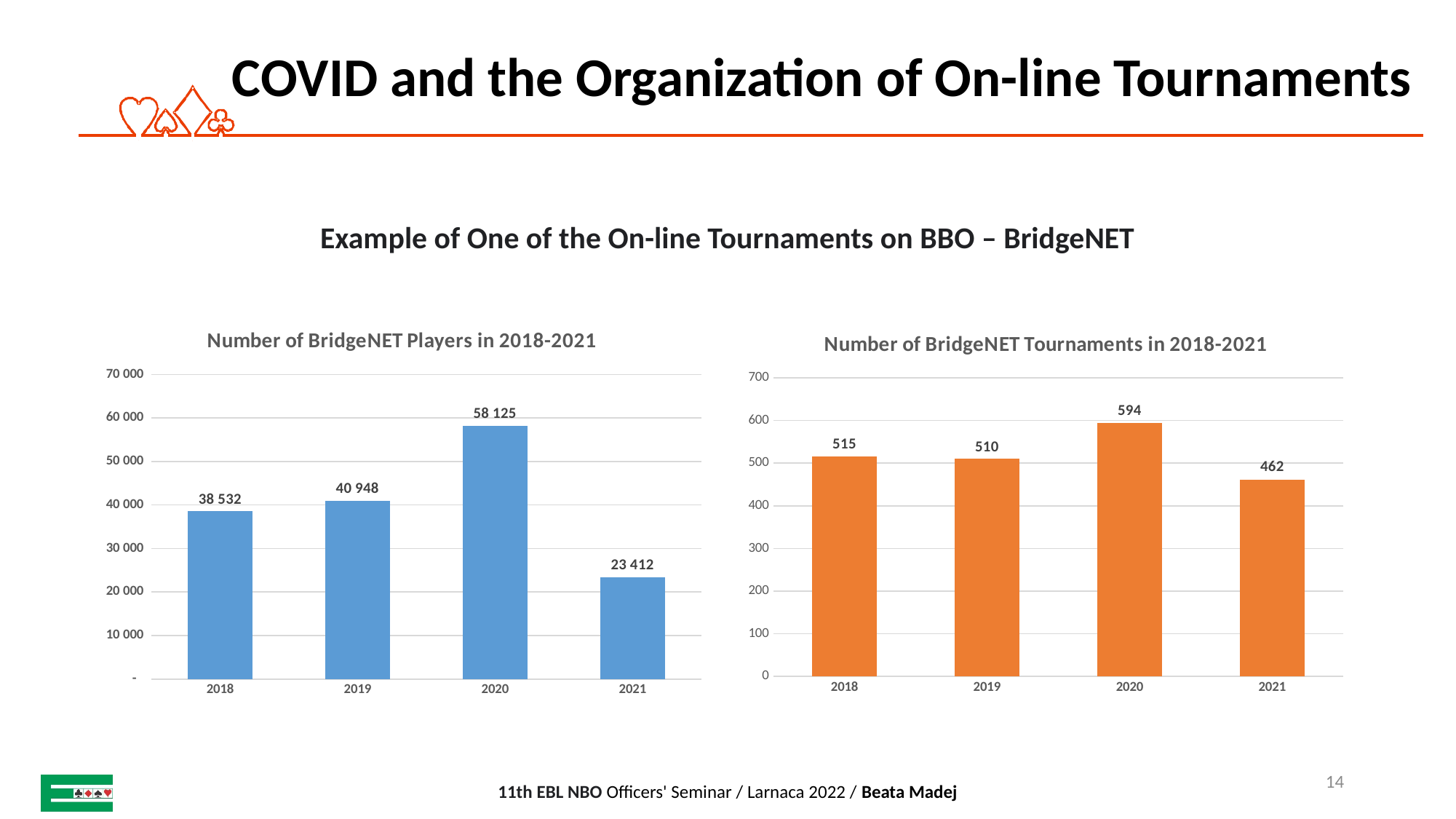
In the 'Number of BridgeNET Tournaments in 2018-2021' chart, what is the value for 2021? 462 What colour are the bars in the 'Number of BridgeNET Tournaments in 2018-2021' chart? Orange In the 'Number of BridgeNET Players in 2018-2021' chart, is the value for 2021 greater or less than 30 000? less In the 'Number of BridgeNET Tournaments in 2018-2021' chart, which is larger, the value for 2018 or the value for 2021? 2018 In the 'Number of BridgeNET Players in 2018-2021' chart, what is the value for 2020? 58 125 In the 'Number of BridgeNET Tournaments in 2018-2021' chart, what is the difference between the 2020 and 2021 values? 132 In the 'Number of BridgeNET Tournaments in 2018-2021' chart, which year has the highest number of tournaments? 2020 In the 'Number of BridgeNET Players in 2018-2021' chart, do the values rise or fall from 2020 to 2021? Fall In the 'Number of BridgeNET Players in 2018-2021' chart, what is the difference between the 2019 and 2018 values? 2 416 What kind of chart is the 'Number of BridgeNET Tournaments in 2018-2021' chart? Bar chart In the 'Number of BridgeNET Players in 2018-2021' chart, which year has the lowest number of players? 2021 In the 'Number of BridgeNET Players in 2018-2021' chart, how many years are shown on the x axis? 4